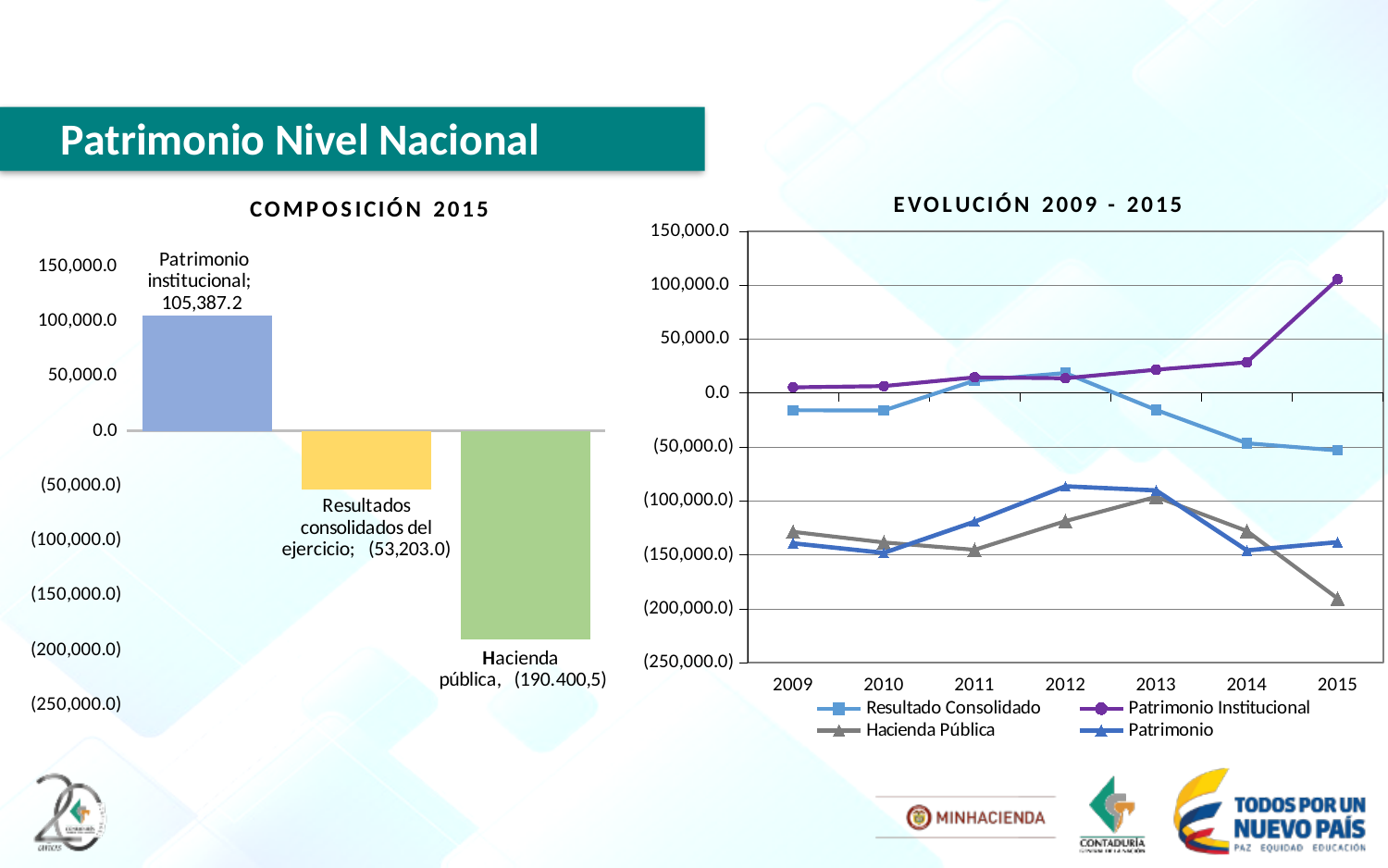
In the COMPOSICIÓN 2015 chart, what is the value for Hacienda pública? (190.400,5) What kind of chart is the COMPOSICIÓN 2015 chart? Bar chart In the COMPOSICIÓN 2015 chart, how many bars are plotted? 3 What kind of chart is the EVOLUCIÓN 2009 - 2015 chart? Line chart In the EVOLUCIÓN 2009 - 2015 chart, does the Patrimonio Institucional series rise or fall from 2009 to 2015? Rise In the EVOLUCIÓN 2009 - 2015 chart, is the value for Patrimonio Institucional in 2015 greater or less than 50,000.0? Greater How many series does the legend of the EVOLUCIÓN 2009 - 2015 chart list? 4 In the COMPOSICIÓN 2015 chart, what is the value for Patrimonio institucional? 105,387.2 In the COMPOSICIÓN 2015 chart, which category has the lowest value? Hacienda pública In the COMPOSICIÓN 2015 chart, what is the value for Resultados consolidados del ejercicio? (53,203.0) In the EVOLUCIÓN 2009 - 2015 chart, which series has the highest value in 2015? Patrimonio Institucional In the COMPOSICIÓN 2015 chart, which category has the highest value? Patrimonio institucional